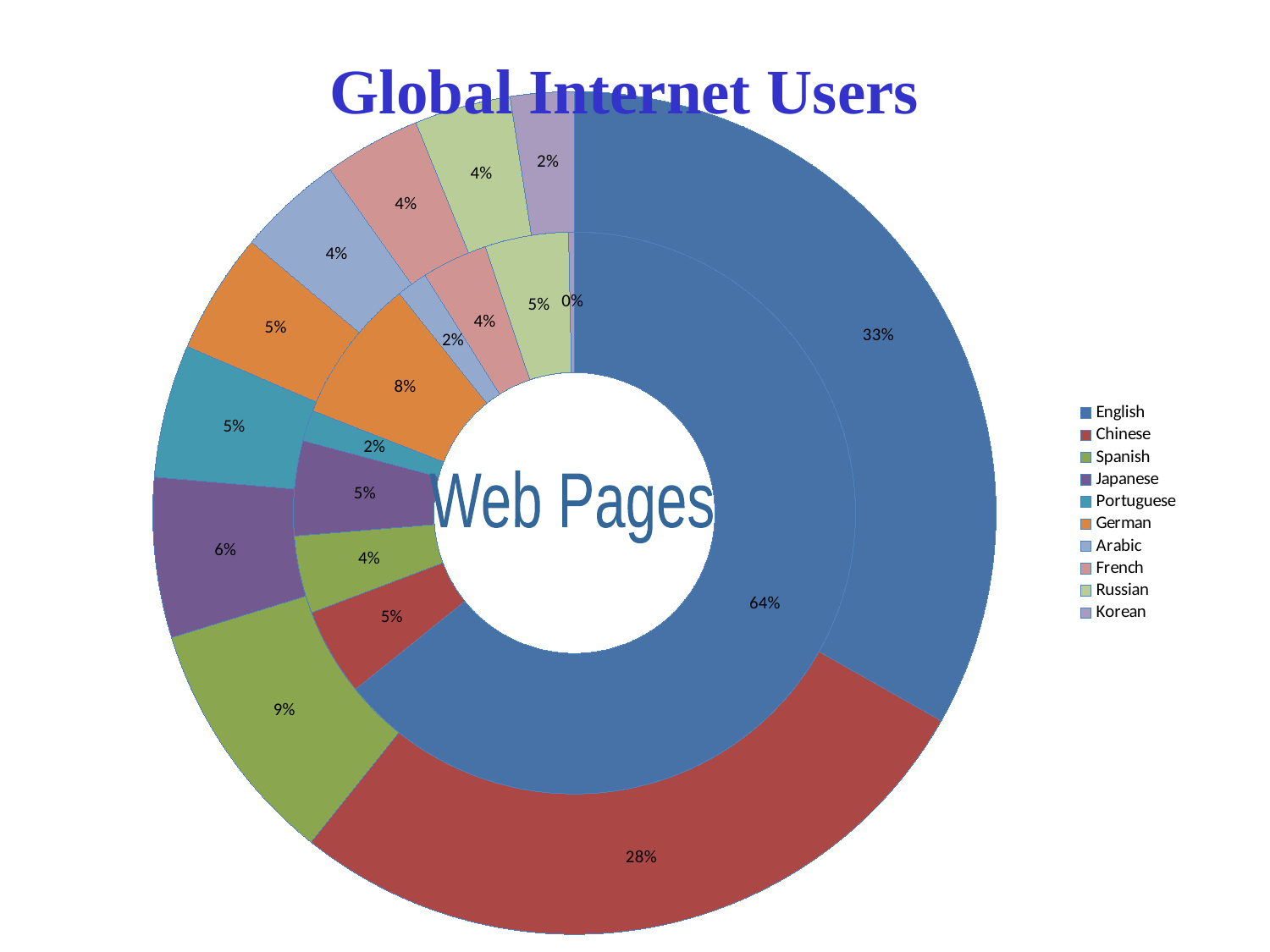
In the outer ring (Global Internet Users), what share is labelled for Spanish? 9% What is the difference between the English share in the inner ring (Web Pages) and the English share in the outer ring (Global Internet Users)? 31% In the inner ring (Web Pages), what share is labelled for English? 64% What kind of chart is shown on the slide? doughnut chart In the outer ring (Global Internet Users), what share is labelled for Chinese? 28% In the inner ring (Web Pages), what share is labelled for German? 8% Which language has the largest share in the outer ring (Global Internet Users)? English How many languages does the legend list? 10 In the outer ring (Global Internet Users), what share is labelled for English? 33% What is the title of the chart? Global Internet Users Which language has the smallest share in the inner ring (Web Pages)? Korean In the outer ring (Global Internet Users), which is larger: the share for Spanish or the share for Japanese? Spanish